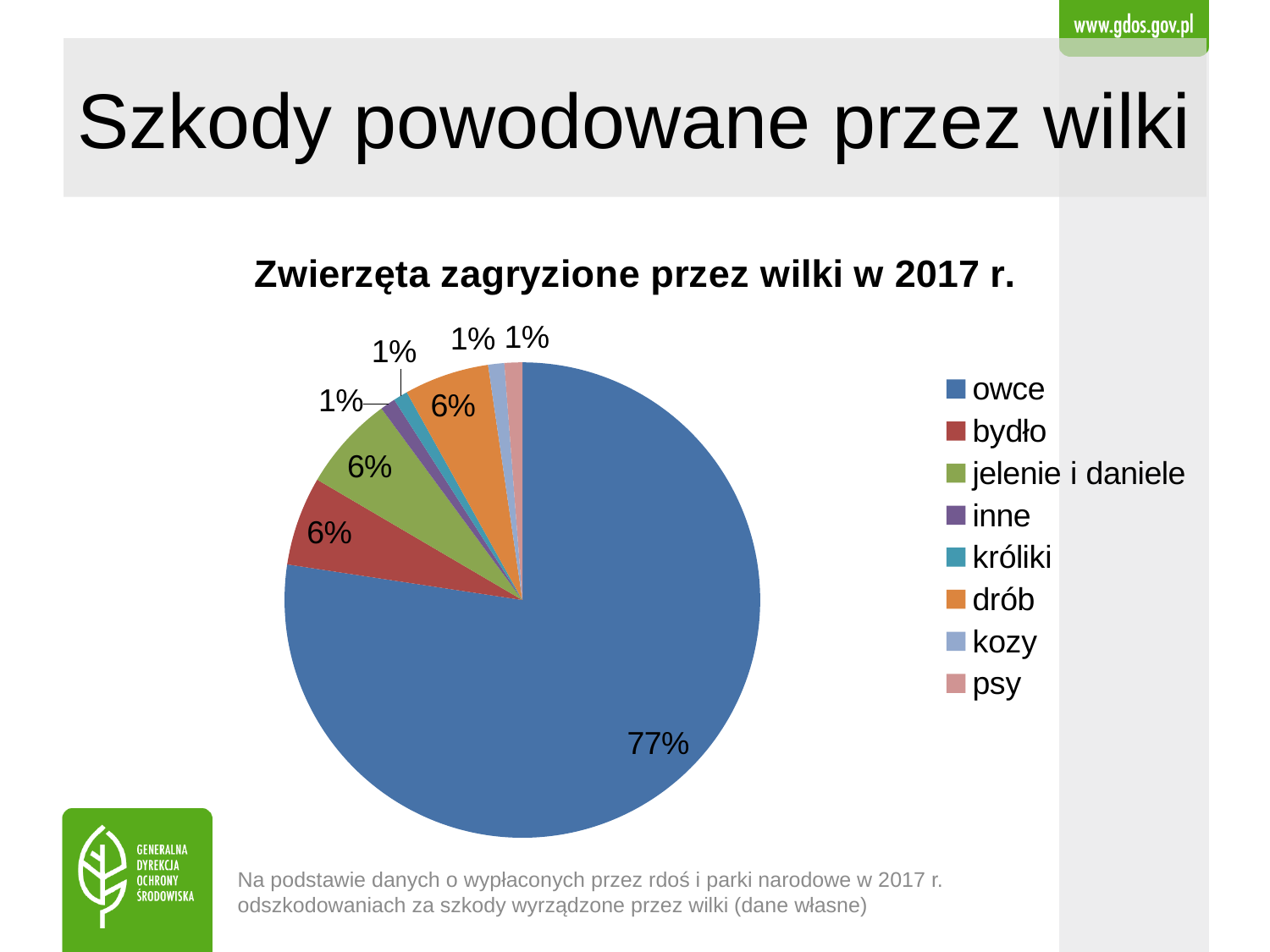
Which colour is used for the owce slice? blue Which is larger, the slice for owce or the slice for jelenie i daniele? owce What kind of chart is shown on the slide? pie chart What share of the pie does drób represent? 6% What share of the pie does kozy represent? 1% What share of the pie does bydło represent? 6% How many categories does the legend of the pie chart list? 8 What is the title of the chart? Zwierzęta zagryzione przez wilki w 2017 r. What is the difference between the share for owce and the share for bydło? 71% Which category has the largest slice of the pie? owce